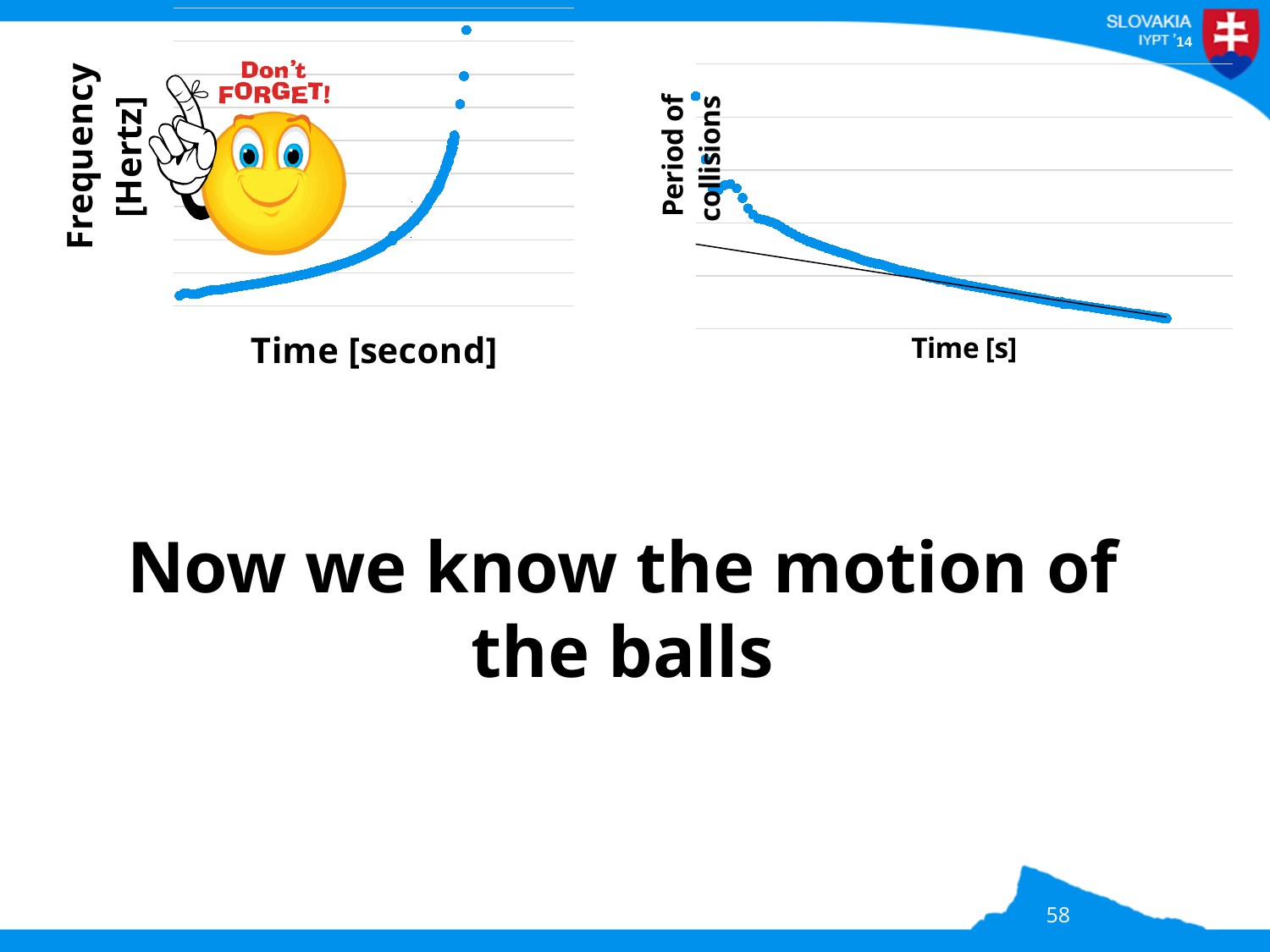
What is the y-axis label of the right chart? Period of collisions How many charts are shown on the slide? 2 What is the x-axis label of the left chart? Time [second] In the right chart, do the period of collisions values overall rise or fall as time increases? fall What kind of chart is the right chart on the slide? scatter chart What kind of chart is the left chart on the slide? scatter chart In the left chart, do the frequency values rise or fall as time increases? rise